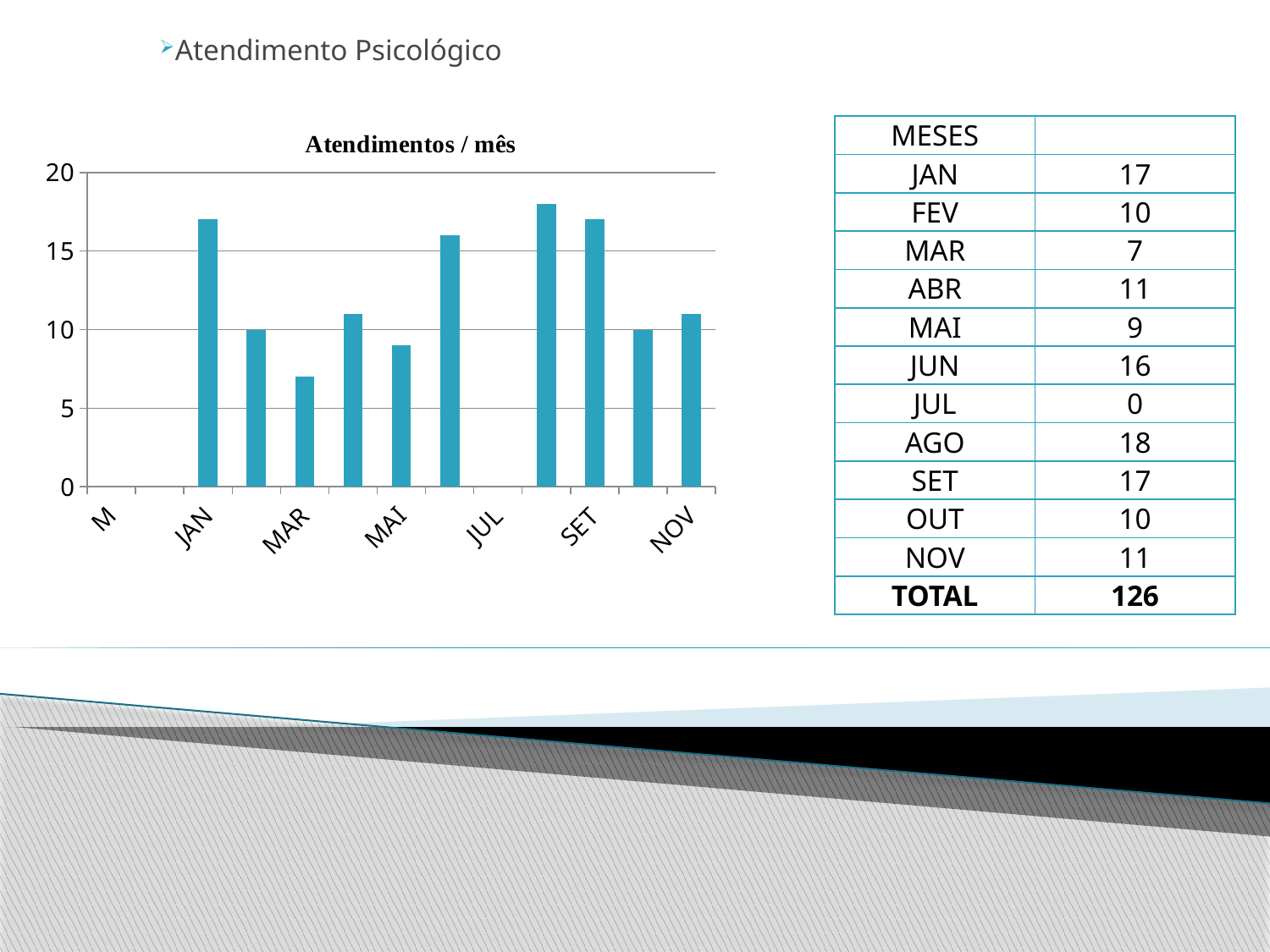
Is the value for MAI greater or less than 10? less What is the title of the chart? Atendimentos / mês Which month has the lowest number of atendimentos? JUL Which month has more atendimentos, JUN or ABR? JUN What kind of chart is shown on the slide? bar chart How many atendimentos were recorded in JUN? 16 What is the total number of atendimentos across all months? 126 Which month has the highest number of atendimentos? AGO How many atendimentos were recorded in JAN? 17 What is the difference between the atendimentos in AGO and in MAR? 11 Is the value for SET greater or less than 15? greater How many atendimentos were recorded in MAR? 7